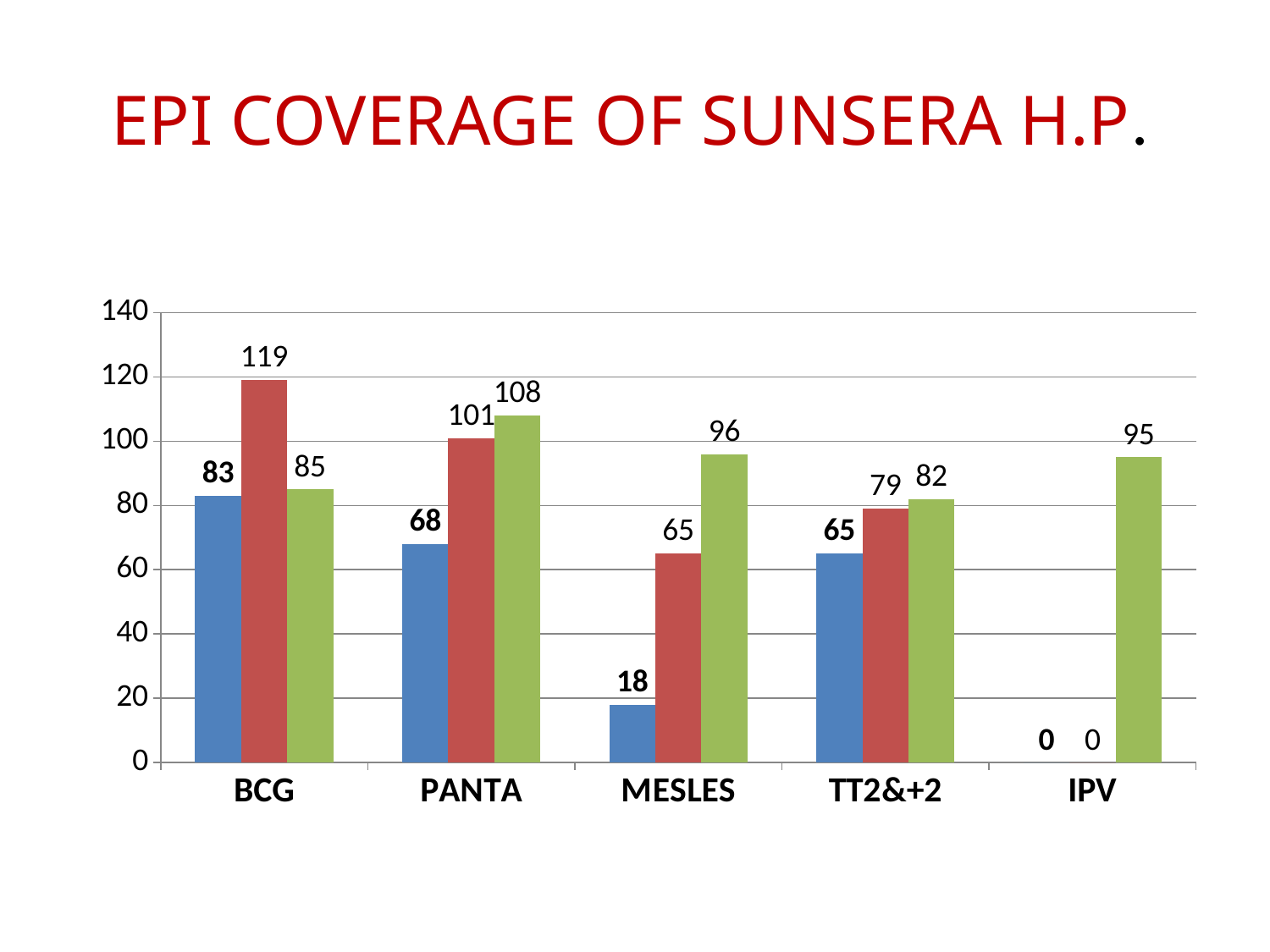
Which category has the highest red bar? BCG What is the value of the green bar for PANTA? 108 Which category has the lowest green bar? TT2&+2 What is the difference between the red bar and the blue bar for BCG? 36 What is the value of the red bar for MESLES? 65 What kind of chart is shown on the slide? bar chart What is the value of the blue bar for BCG? 83 What is the value of the green bar for IPV? 95 What is the title of the slide? EPI COVERAGE OF SUNSERA H.P. How many categories are shown on the x axis? 5 Which is larger for MESLES, the blue bar or the green bar? the green bar Is the value of the red bar for PANTA greater or less than 100? greater